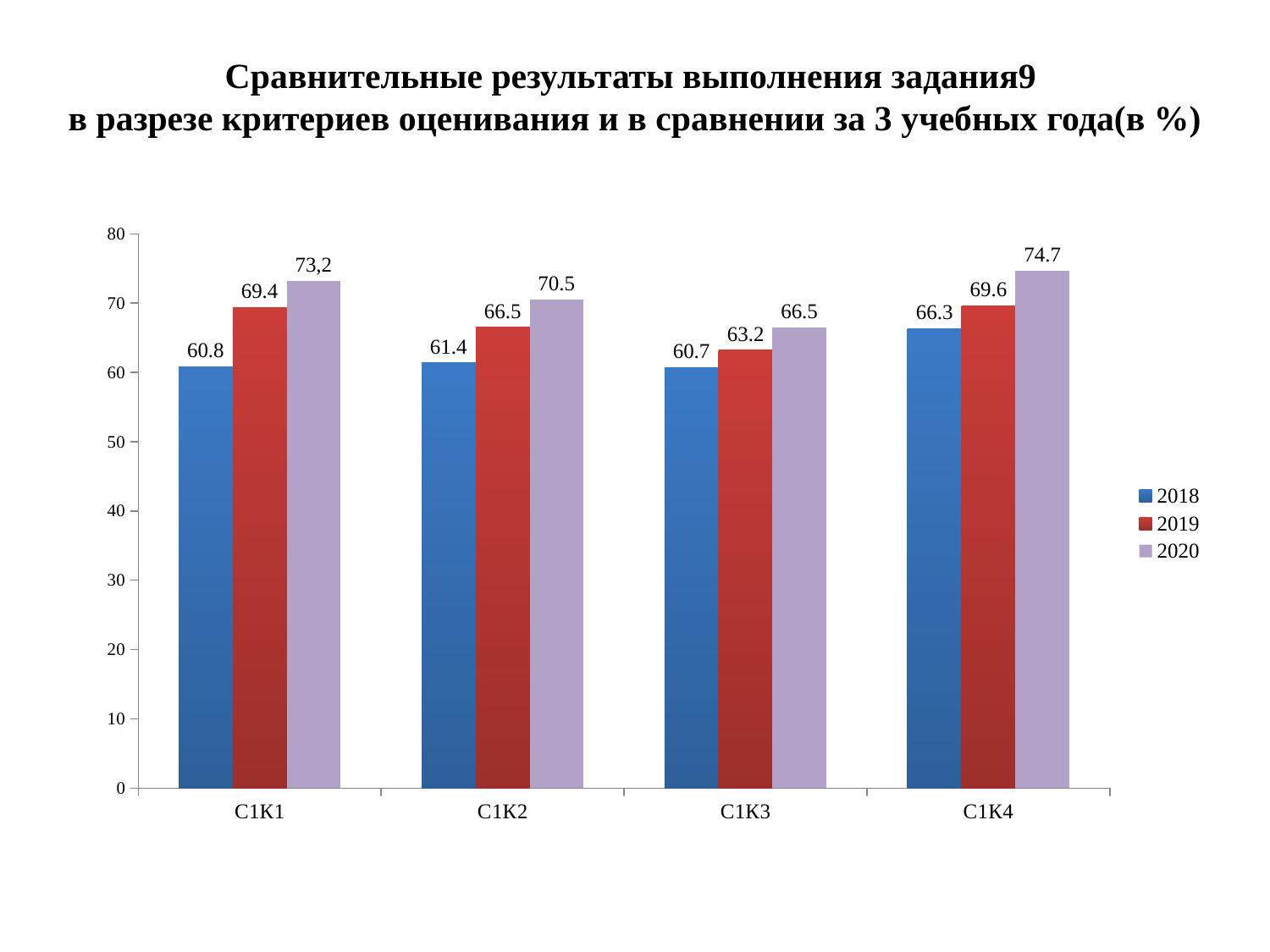
Which colour represents the 2019 series in the legend? Red How many series does the legend list? 3 Which is larger: the 2019 value for С1К1 or the 2019 value for С1К4? 2019 value for С1К4 Which category has the highest value for the 2020 series? С1К4 What is the difference between the 2019 and 2018 values in category С1К3? 2.5 What is the value for 2020 in category С1К4? 74.7 What kind of chart is shown on the slide? Bar chart How many categories are shown on the x axis? 4 What is the value for 2020 in category С1К1? 73,2 Which category has the lowest value for the 2018 series? С1К3 What is the value for 2019 in category С1К3? 63.2 What is the value for 2018 in category С1К2? 61.4